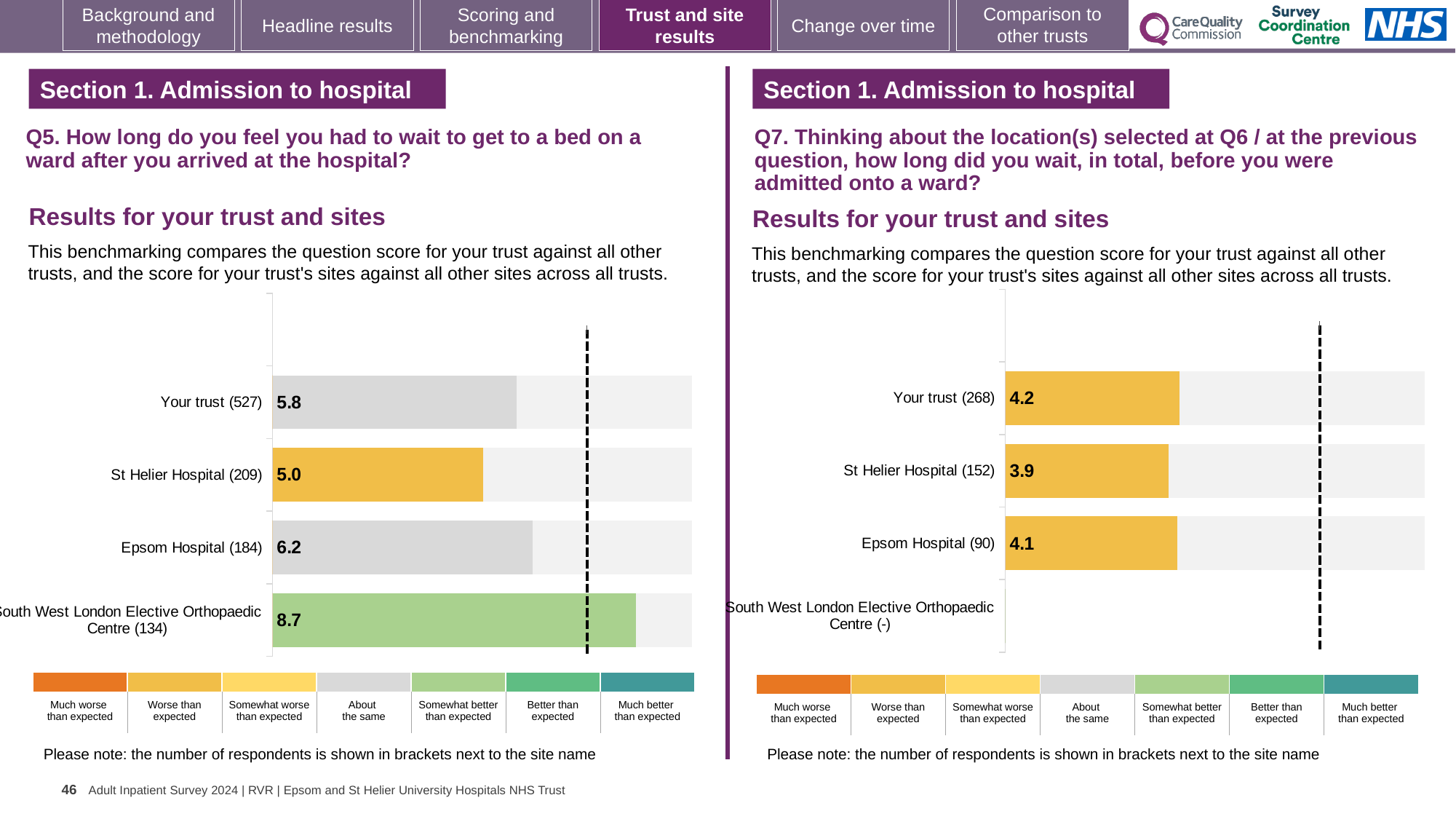
What kind of chart is the Q5 chart on the left? Bar chart In the Q7 chart on the right, which is higher: the score for St Helier Hospital (152) or Epsom Hospital (90)? Epsom Hospital (90) In the Q5 chart on the left, what is the difference between the scores for Epsom Hospital (184) and St Helier Hospital (209)? 1.2 In the Q5 chart on the left, which benchmark category does the green bar for South West London Elective Orthopaedic Centre (134) correspond to in the key? Somewhat better than expected In the Q7 chart on the right, what is the score for Your trust (268)? 4.2 In the Q5 chart on the left, how many bars are plotted? 4 In the Q5 chart on the left, which site has the highest score? South West London Elective Orthopaedic Centre (134) In the Q5 chart on the left, what is the score for St Helier Hospital (209)? 5.0 In the Q7 chart on the right, what is the difference between the scores for Your trust (268) and St Helier Hospital (152)? 0.3 In the Q7 chart on the right, what is the score for Epsom Hospital (90)? 4.1 In the Q5 chart on the left, what is the score for Your trust (527)? 5.8 In the Q5 chart on the left, which site has the lowest score? St Helier Hospital (209)